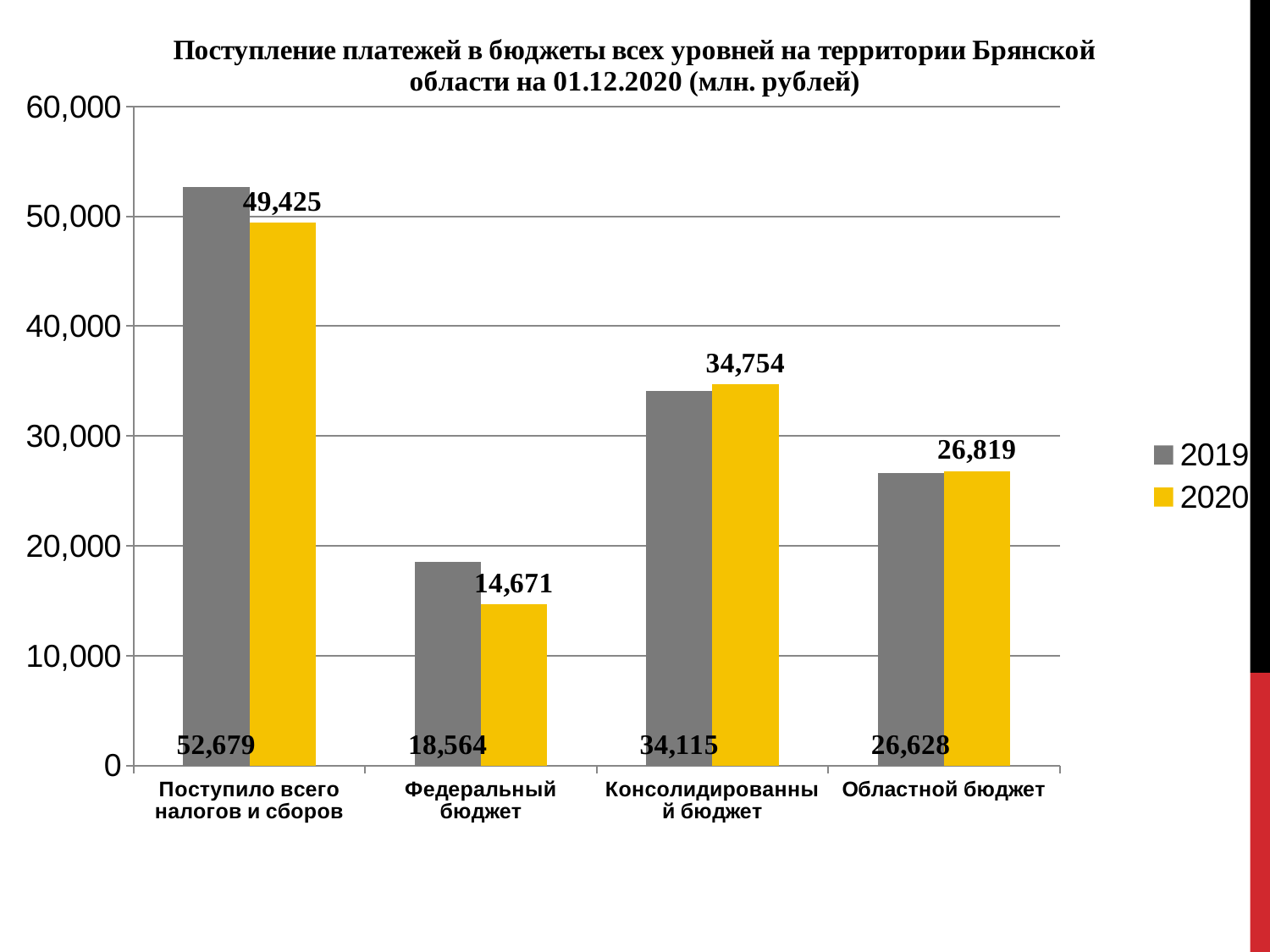
Which category has the lowest 2019 value? Федеральный бюджет What is the 2020 value for Консолидированный бюджет? 34,754 Which category has the highest 2020 value? Поступило всего налогов и сборов What is the difference between the 2020 and 2019 values for Консолидированный бюджет? 639 What is the difference between the 2019 and 2020 values for Поступило всего налогов и сборов? 3,254 What is the 2019 value for Областной бюджет? 26,628 How many categories are shown on the x axis? 4 What is the 2019 value for Поступило всего налогов и сборов? 52,679 Which is larger for Федеральный бюджет: the 2019 value or the 2020 value? 2019 What kind of chart is shown on the slide? Bar chart How many series does the legend list? 2 What is the 2020 value for Федеральный бюджет? 14,671